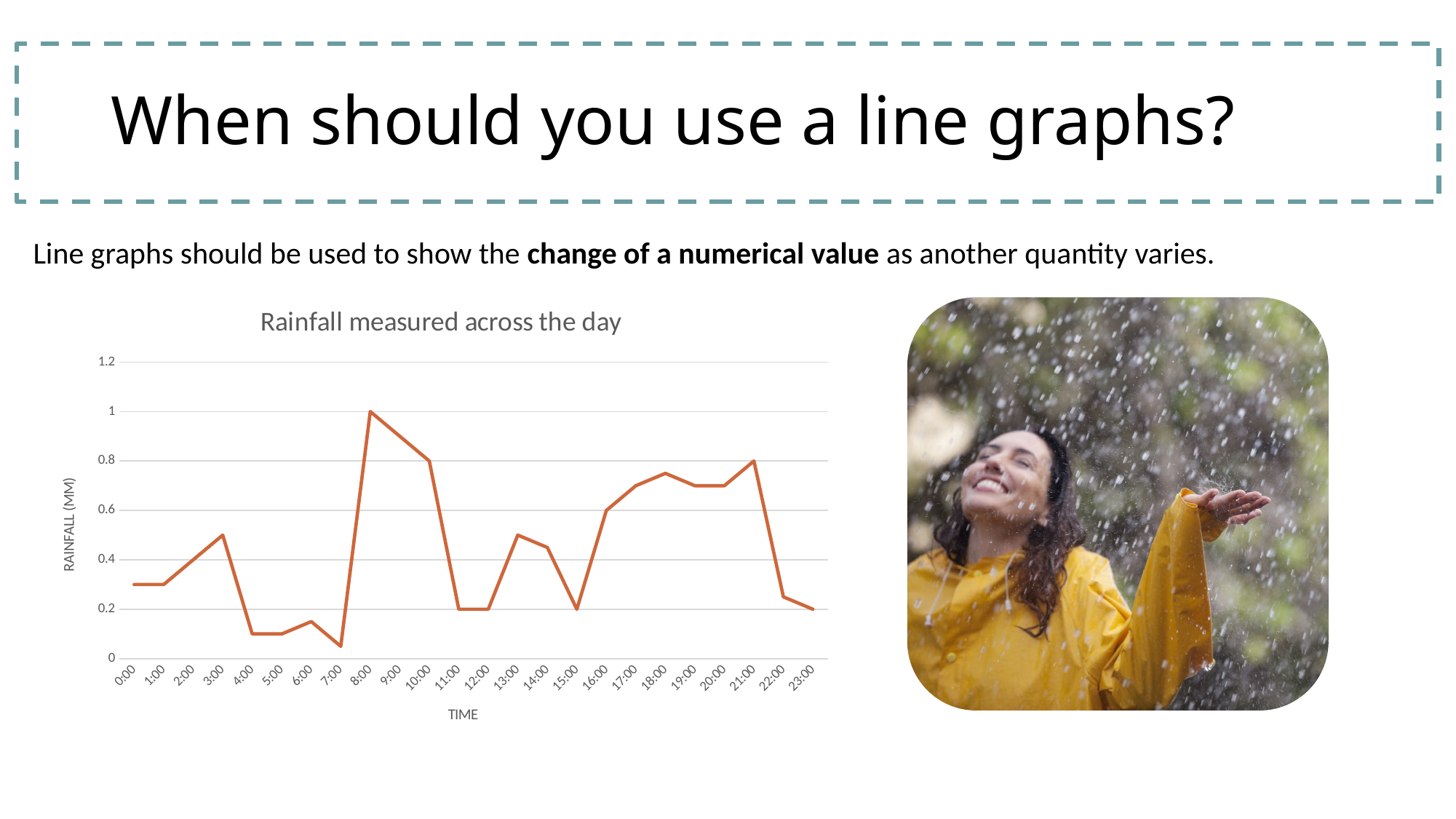
At which time is the rainfall lowest? 7:00 What is the title of the chart? Rainfall measured across the day What kind of chart is shown on the slide? line chart How many time points are plotted along the x axis of the chart? 24 What is the rainfall value at 8:00? 1 Is the rainfall at 3:00 greater or less than 0.4? greater What is the rainfall value at 10:00? 0.8 What is the label on the vertical axis of the chart? RAINFALL (MM) Does the rainfall rise or fall between 21:00 and 23:00? fall Which time has higher rainfall, 18:00 or 14:00? 18:00 Is the rainfall at 4:00 greater or less than 0.2? less At which time is the rainfall highest? 8:00